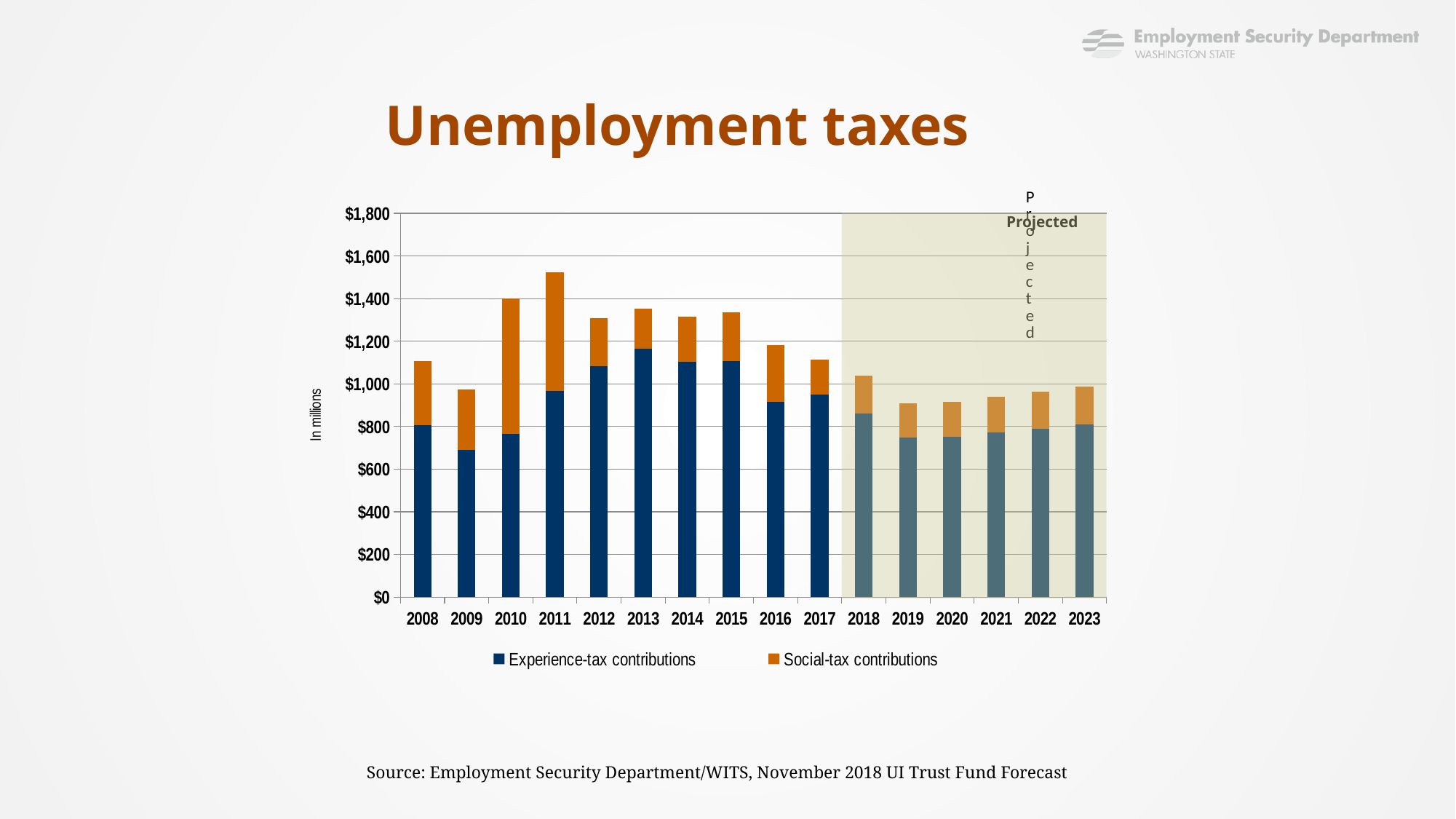
Is the total for 2011 greater or less than $1,400? greater Are the Experience-tax contributions for 2013 greater or less than $1,000? greater What kind of chart is shown on the slide? Stacked bar chart Which year has a larger total, 2010 or 2012? 2010 Do the total contributions rise or fall from 2019 to 2023? rise Which year has the lowest Experience-tax contributions? 2009 What label is shown on the shaded region covering 2018 to 2023? Projected How many years are shown on the x axis? 16 How many series does the legend list? 2 Which year has the highest total unemployment tax contributions? 2011 Is the total for 2019 greater or less than $1,000? less Which year has the highest Experience-tax contributions? 2013